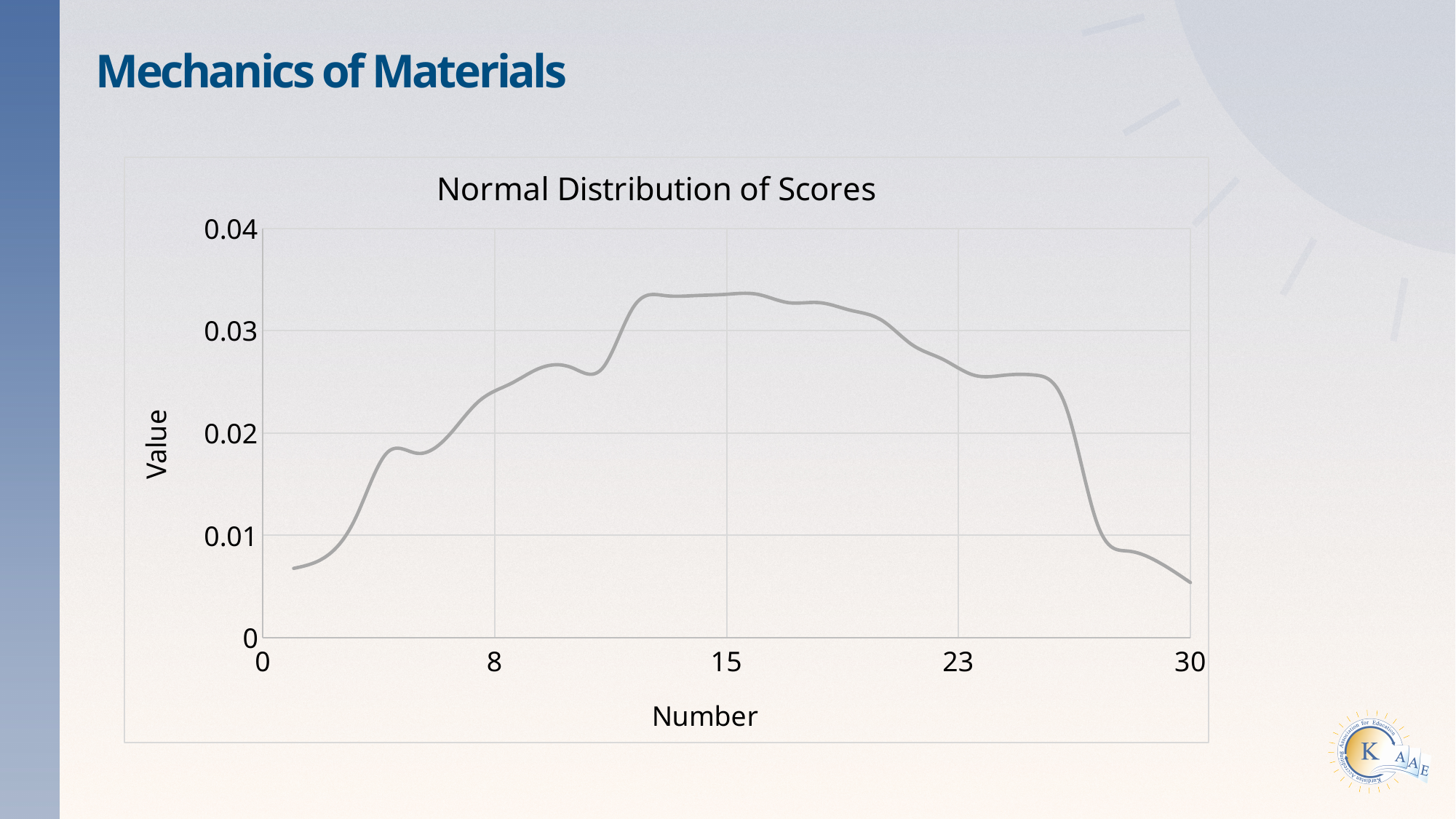
What is the label of the x axis? Number Is the value at Number 30 greater or less than 0.01? less Is the value at Number 15 greater or less than 0.03? greater Is the value at Number 23 greater or less than 0.03? less Which is larger, the value at Number 15 or the value at Number 30? Number 15 Which is larger, the value at Number 8 or the value at Number 23? Number 23 Do the values rise or fall along the x axis between Number 0 and Number 15? rise Do the values rise or fall along the x axis between Number 23 and Number 30? fall What kind of chart is shown on the slide? line chart What is the title of the chart? Normal Distribution of Scores